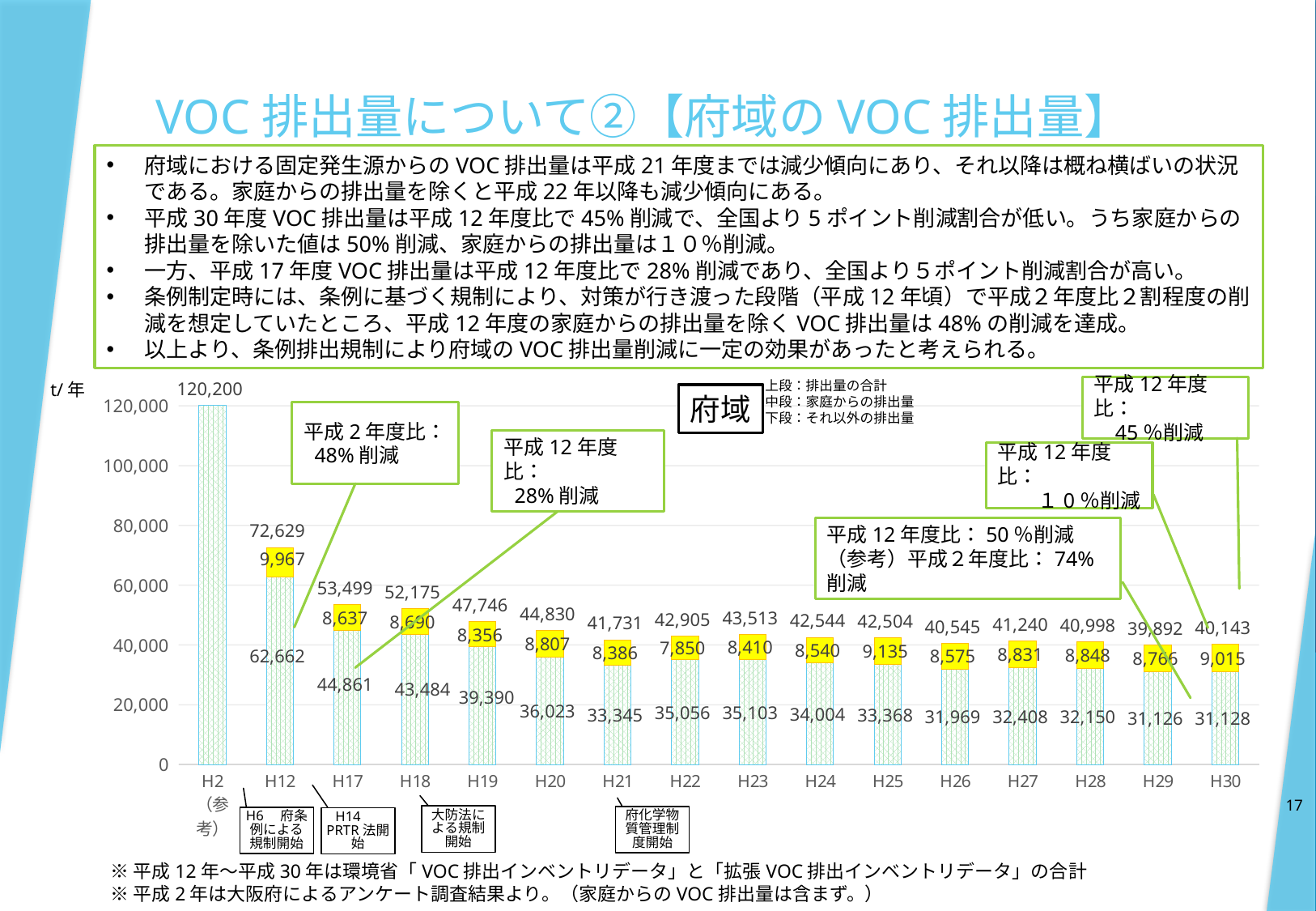
What is the non-household emission value (bottom label) shown for H17? 44,861 Which year has the highest household emission value (middle label)? H12 Is the total VOC emission value for H17 greater or less than 40,000? greater What is the difference between the total VOC emission values for H12 and H30? 32,486 What kind of chart is used to show the VOC emissions? bar chart Which is larger, the total VOC emission value for H23 or for H24? H23 What is the household emission value (middle label) shown for H30? 9,015 Which year has the lowest household emission value (middle label)? H22 What is the total VOC emission value shown for H12? 72,629 Which year has the highest total VOC emission value? H2 What is the difference between the household emission values for H12 and H30? 952 How many years (categories) are shown on the x axis of the chart? 16